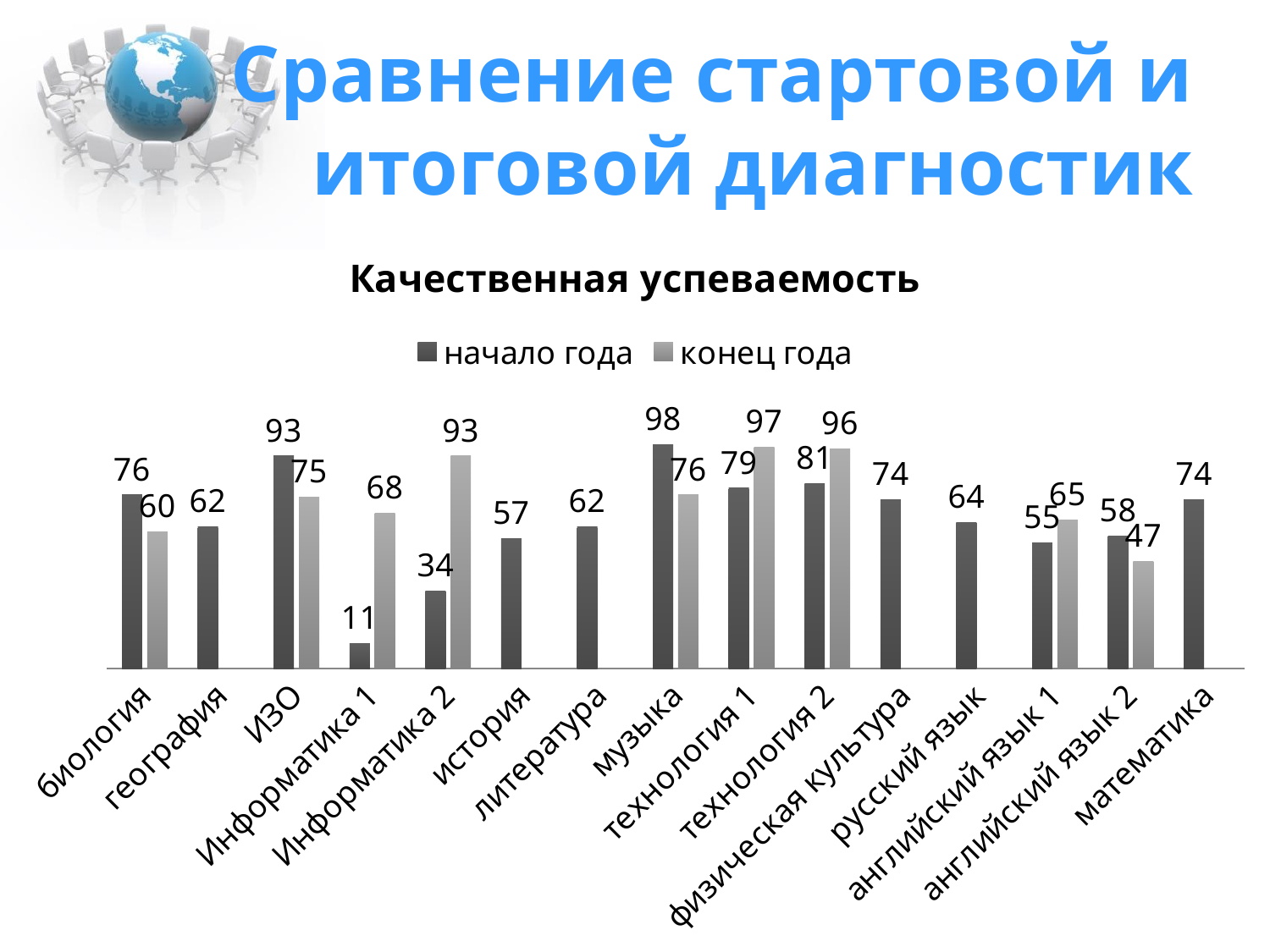
How many categories are shown on the x axis? 15 Which category has the lowest 'начало года' value? Информатика 1 What is the title of the chart? Качественная успеваемость Which category has the lowest 'конец года' value? английский язык 2 Which is larger for ИЗО: the 'начало года' value or the 'конец года' value? начало года What is the difference between the 'конец года' and 'начало года' values for Информатика 1? 57 What type of chart is shown on the slide? bar chart How many series does the legend list? 2 What is the value for 'конец года' for Информатика 2? 93 What is the value for 'начало года' for биология? 76 What is the value for 'конец года' for технология 1? 97 Which category has the highest 'начало года' value? музыка